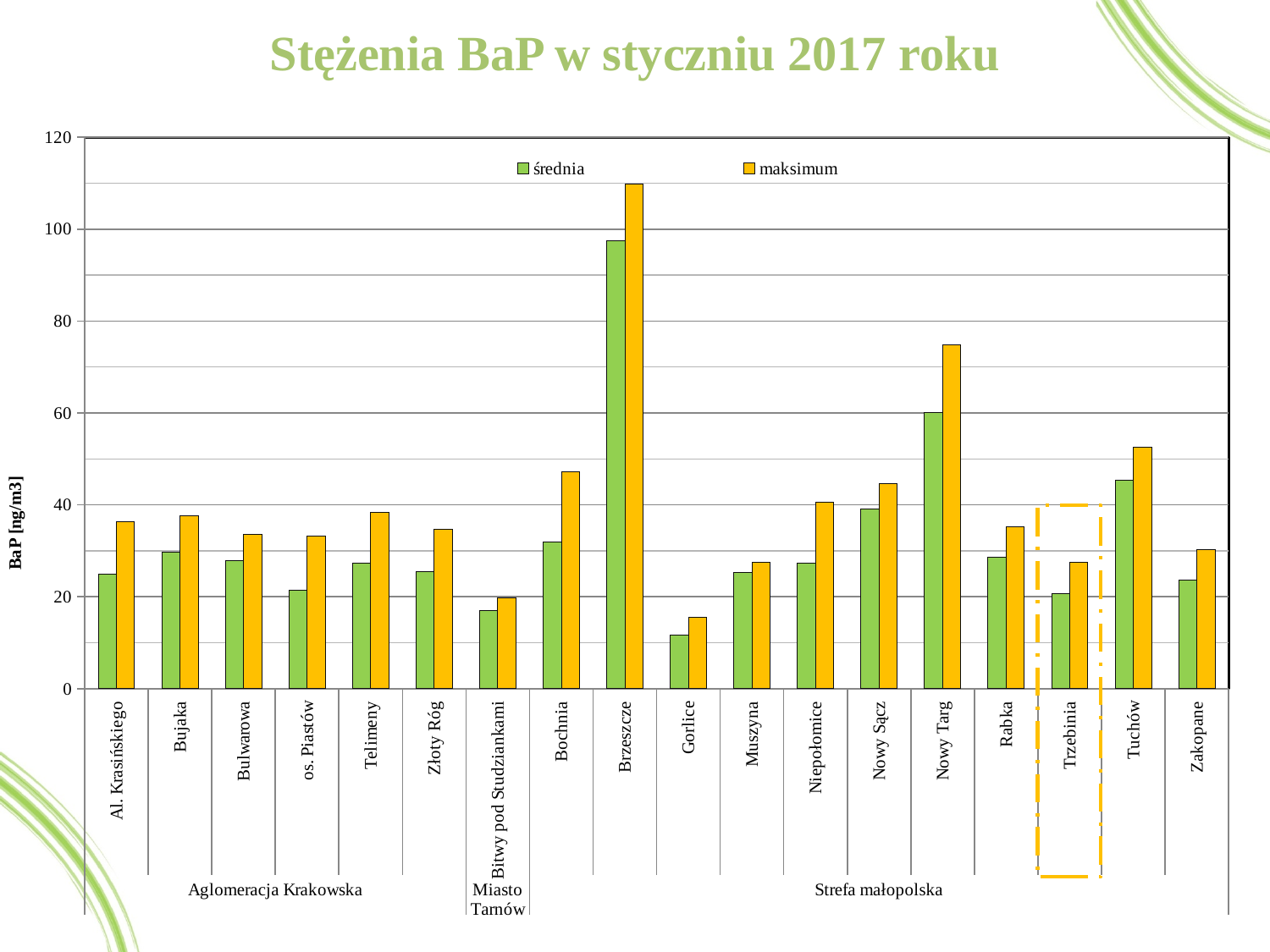
How many series does the legend list? 2 Which is larger, the maksimum value for Nowy Targ or the maksimum value for Tuchów? Nowy Targ Is the maksimum value for Brzeszcze greater or less than 100? greater How many stations (categories) are shown on the x axis? 18 Which is larger, the średnia value for Bochnia or the średnia value for Gorlice? Bochnia Which station has the lowest średnia value? Gorlice What is the label of the y axis? BaP [ng/m3] Is the maksimum value for Nowy Targ greater or less than 60? greater Which station has the highest maksimum value? Brzeszcze Is the maksimum value for Tuchów greater or less than 40? greater What kind of chart is shown on the slide? bar chart